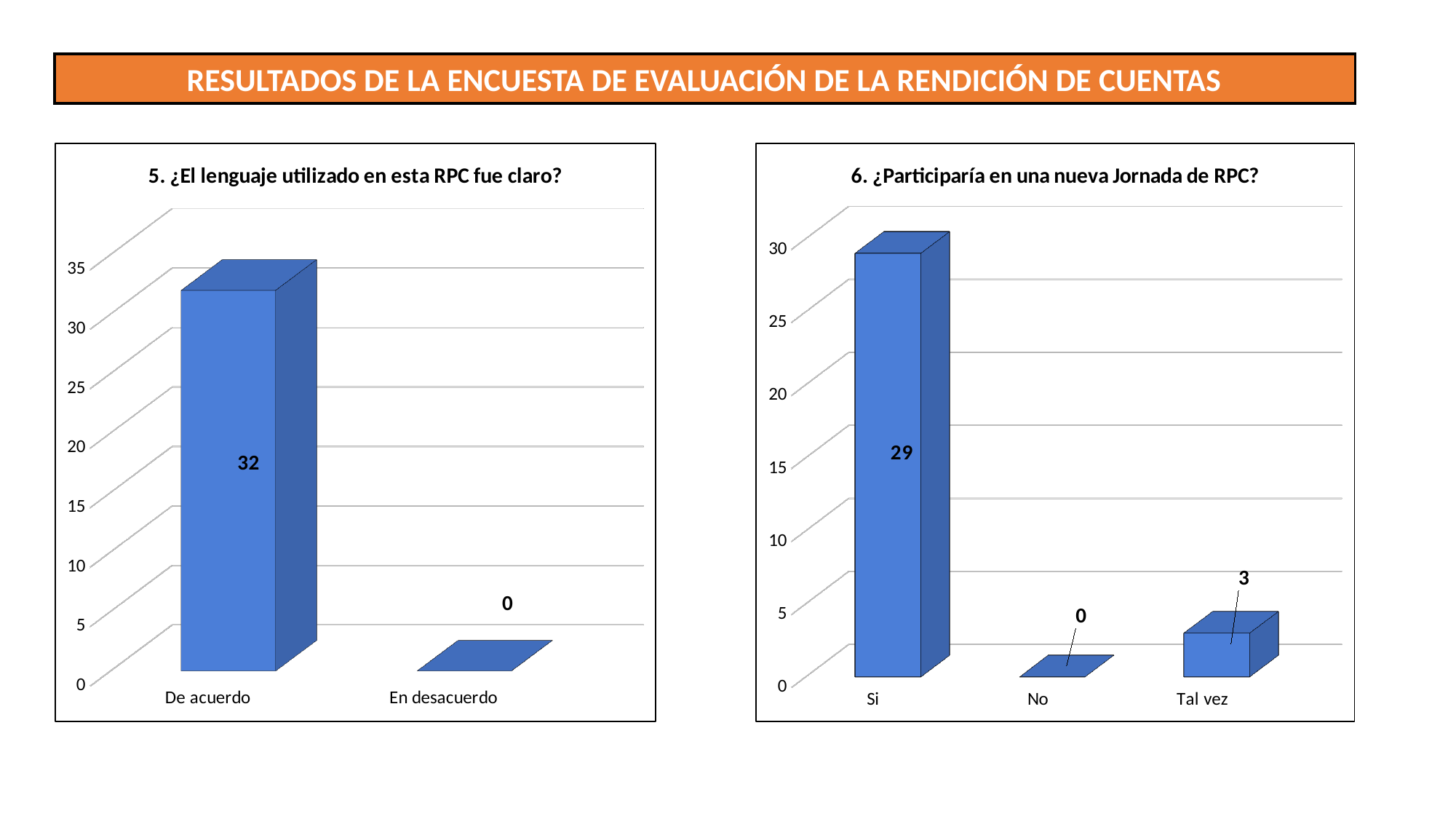
What kind of chart is the right chart '6. ¿Participaría en una nueva Jornada de RPC?'? Bar chart In the right chart '6. ¿Participaría en una nueva Jornada de RPC?', what is the value for 'Tal vez'? 3 In the left chart '5. ¿El lenguaje utilizado en esta RPC fue claro?', what is the difference between 'De acuerdo' and 'En desacuerdo'? 32 In the left chart '5. ¿El lenguaje utilizado en esta RPC fue claro?', what is the value for 'En desacuerdo'? 0 In the right chart '6. ¿Participaría en una nueva Jornada de RPC?', what is the value for 'Si'? 29 In the right chart '6. ¿Participaría en una nueva Jornada de RPC?', what is the difference between 'Si' and 'Tal vez'? 26 In the left chart '5. ¿El lenguaje utilizado en esta RPC fue claro?', what is the value for 'De acuerdo'? 32 In the right chart '6. ¿Participaría en una nueva Jornada de RPC?', which is larger, 'Tal vez' or 'No'? Tal vez In the left chart '5. ¿El lenguaje utilizado en esta RPC fue claro?', which category has the highest value? De acuerdo In the left chart '5. ¿El lenguaje utilizado en esta RPC fue claro?', how many categories are shown on the x axis? 2 In the right chart '6. ¿Participaría en una nueva Jornada de RPC?', how many categories are shown on the x axis? 3 In the right chart '6. ¿Participaría en una nueva Jornada de RPC?', which category has the lowest value? No